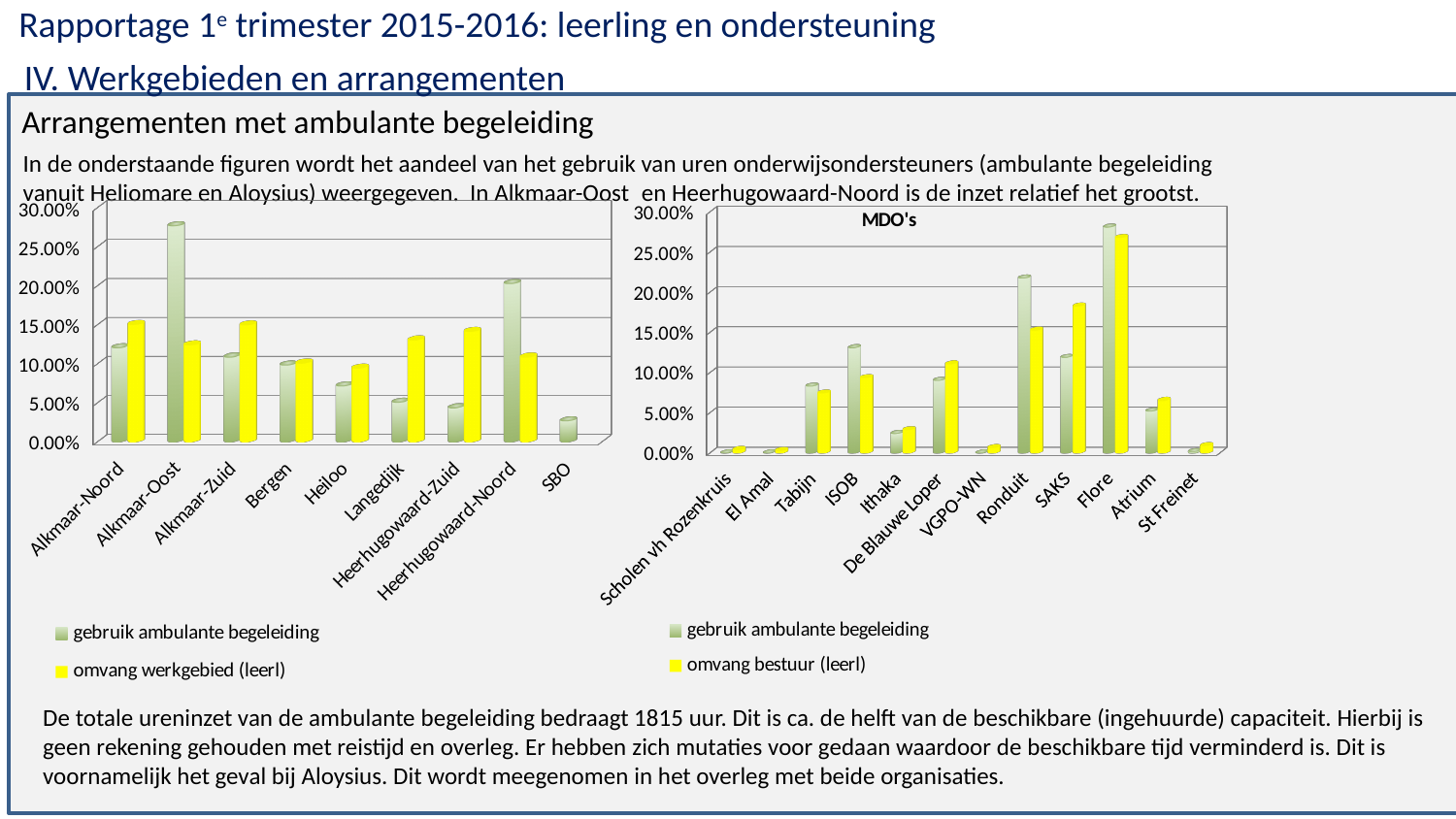
In the left chart, is the gebruik ambulante begeleiding value for Heiloo greater or less than 10.00%? less In the left chart, which category has the highest value for gebruik ambulante begeleiding? Alkmaar-Oost In the left chart, for Heerhugowaard-Noord, which is larger: gebruik ambulante begeleiding or omvang werkgebied (leerl)? gebruik ambulante begeleiding How many categories are shown on the x axis of the left chart? 9 How many categories are shown on the x axis of the MDO's chart? 12 In the MDO's chart, is the gebruik ambulante begeleiding value for Ronduit greater or less than 20.00%? greater What is the second legend entry of the MDO's chart? omvang bestuur (leerl) In the MDO's chart, which category has the highest value for gebruik ambulante begeleiding? Flore In the left chart, which category has the lowest value for gebruik ambulante begeleiding? SBO In the left chart, is the gebruik ambulante begeleiding value for Alkmaar-Oost greater or less than 25.00%? greater What kind of chart is the left chart on the slide? bar chart How many series does the legend of the MDO's chart list? 2